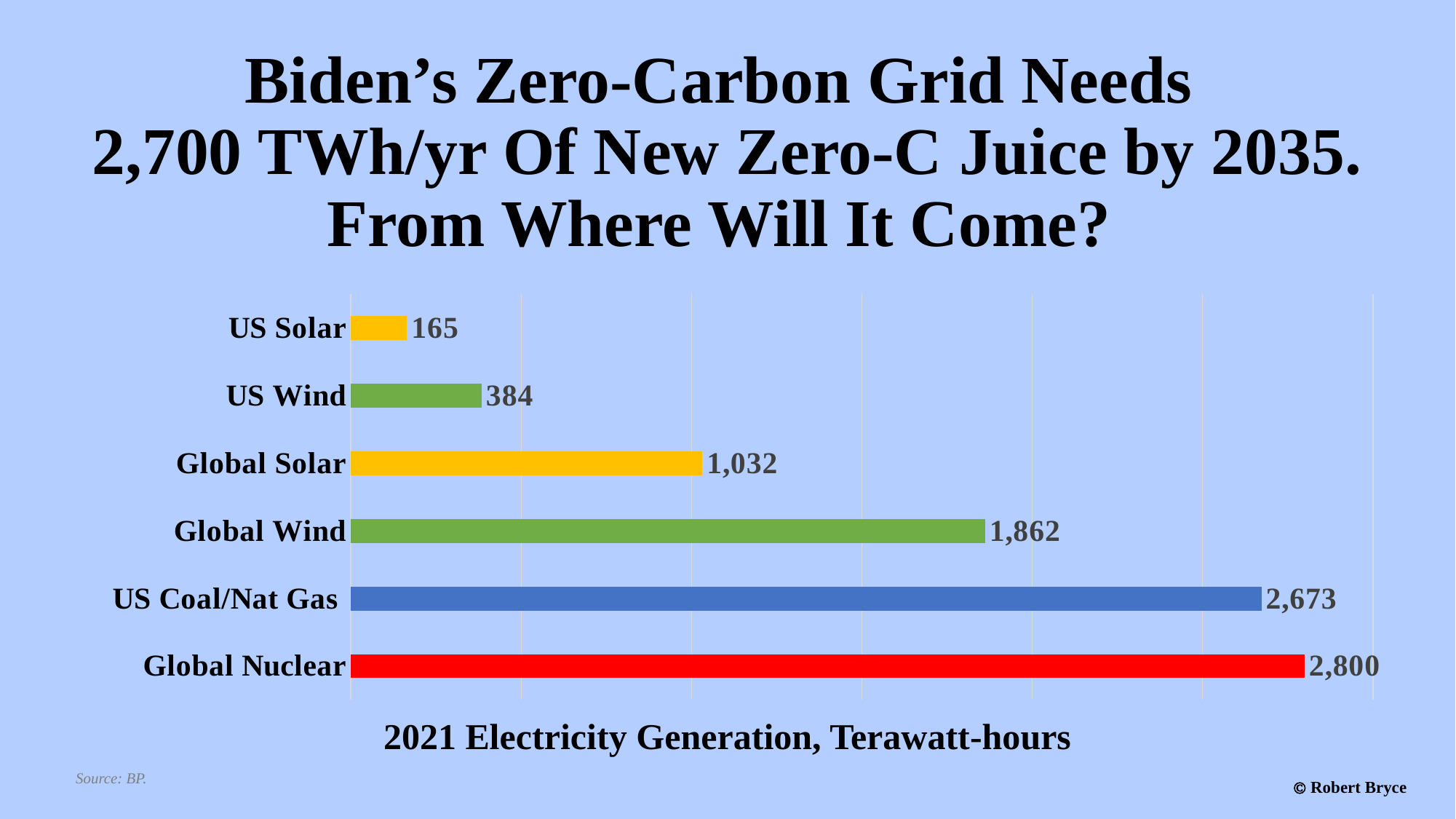
What colour is the Global Nuclear bar? Red What is the difference between Global Nuclear and US Coal/Nat Gas? 127 What is the value for Global Nuclear? 2,800 What is the axis label shown below the bars? 2021 Electricity Generation, Terawatt-hours Which category has the highest value? Global Nuclear What is the difference between Global Wind and Global Solar? 830 Which is larger, US Wind or US Solar? US Wind Which category has the lowest value? US Solar What is the value for Global Solar? 1,032 What kind of chart is shown on the slide? Bar chart How many categories are shown in the chart? 6 What is the value for US Wind? 384